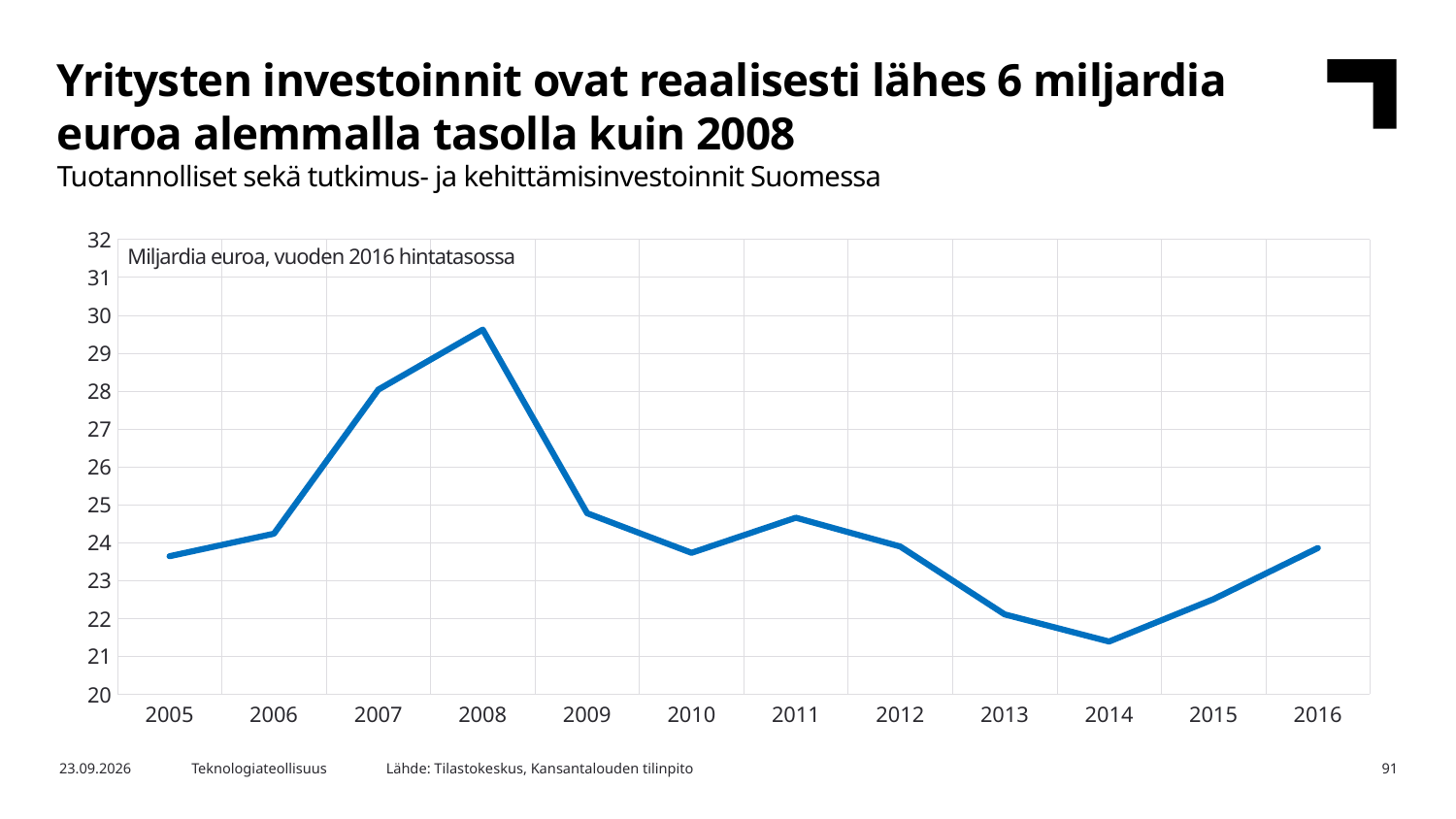
What kind of chart is shown on the slide? line chart In which year do the investments reach their lowest value? 2014 How many years are plotted on the x axis of the chart? 12 Do the values rise or fall from 2008 to 2010? fall In which year do the investments reach their highest value? 2008 Which year has the larger value, 2008 or 2009? 2008 Which year has the larger value, 2014 or 2016? 2016 Is the value for 2007 greater or less than 27? greater Is the value for 2013 greater or less than 23? less Is the value for 2014 greater or less than 22? less What unit is stated in the label inside the chart area? Miljardia euroa, vuoden 2016 hintatasossa